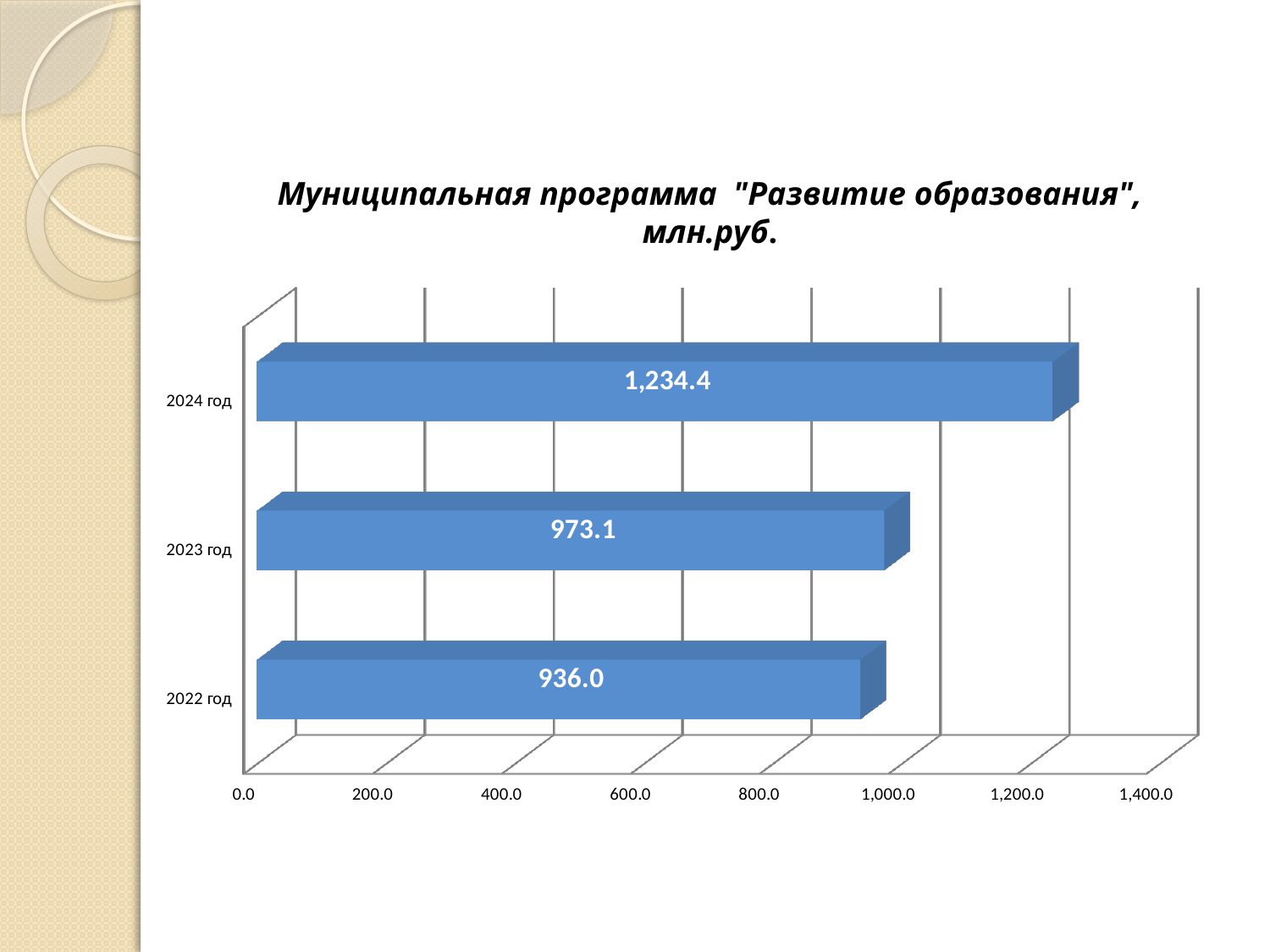
Which year has the lowest value? 2022 год How many years are shown on the chart? 3 What is the title of the chart? Муниципальная программа "Развитие образования", млн.руб. Is the value for 2024 год greater or less than 1,200.0? greater What is the difference between the values for 2024 год and 2023 год? 261.3 What is the value for 2022 год? 936.0 Which year has the highest value? 2024 год What is the difference between the values for 2023 год and 2022 год? 37.1 What is the value for 2024 год? 1,234.4 What kind of chart is shown on the slide? bar chart What is the value for 2023 год? 973.1 Which is larger, the value for 2023 год or the value for 2022 год? 2023 год